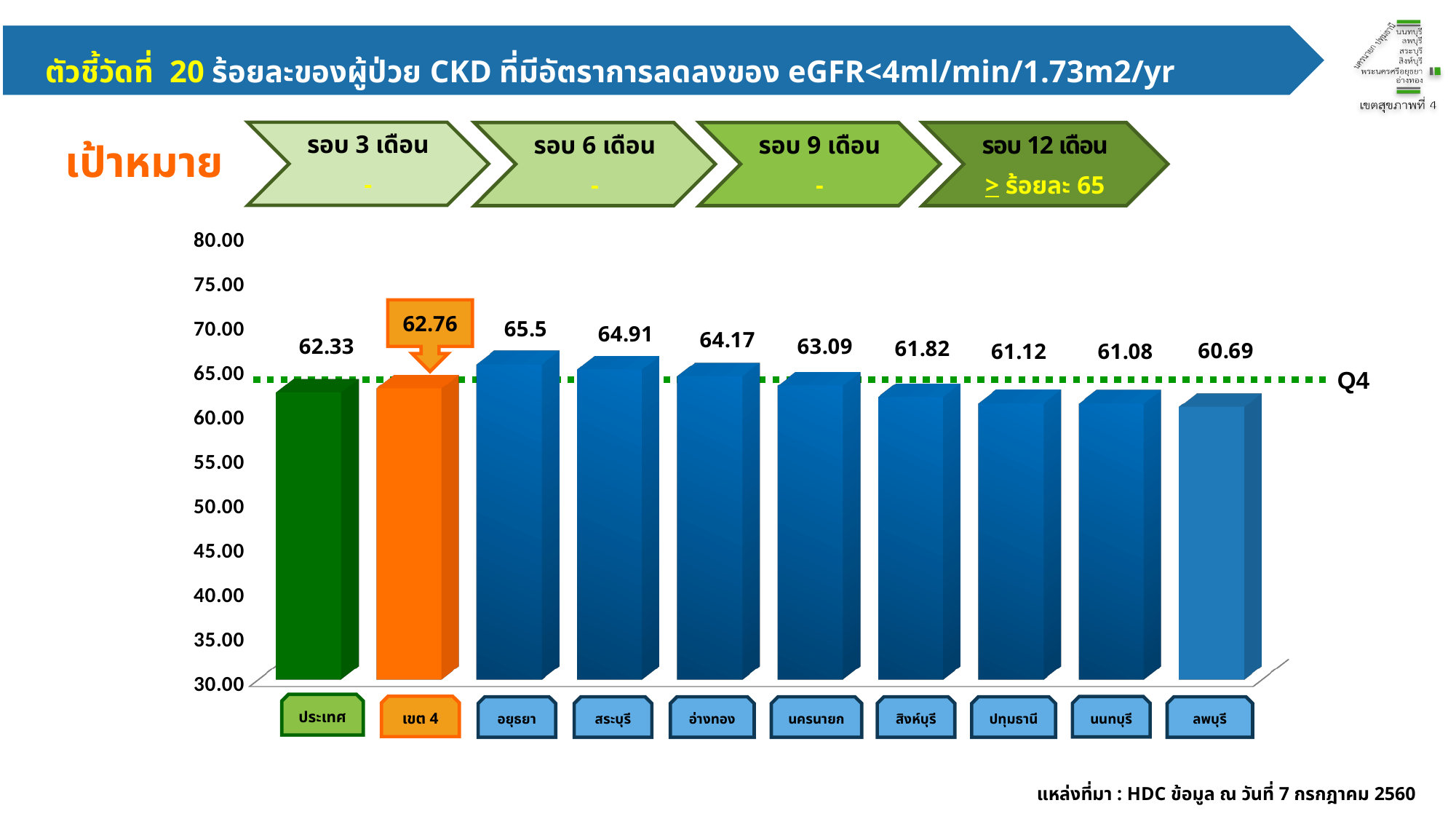
What is the value for ลพบุรี? 60.69 What kind of chart is shown on the slide? bar chart What is the value for ประเทศ? 62.33 Which is larger, the value for สระบุรี or the value for นครนายก? สระบุรี What is the target value shown for รอบ 12 เดือน? ≥ ร้อยละ 65 How many categories are shown in the chart? 10 Which category has the highest value? อยุธยา What is the difference between the values for อยุธยา and ลพบุรี? 4.81 What is the difference between the values for เขต 4 and ประเทศ? 0.43 Which category has the lowest value? ลพบุรี What is the value for เขต 4? 62.76 What is the value for อยุธยา? 65.5